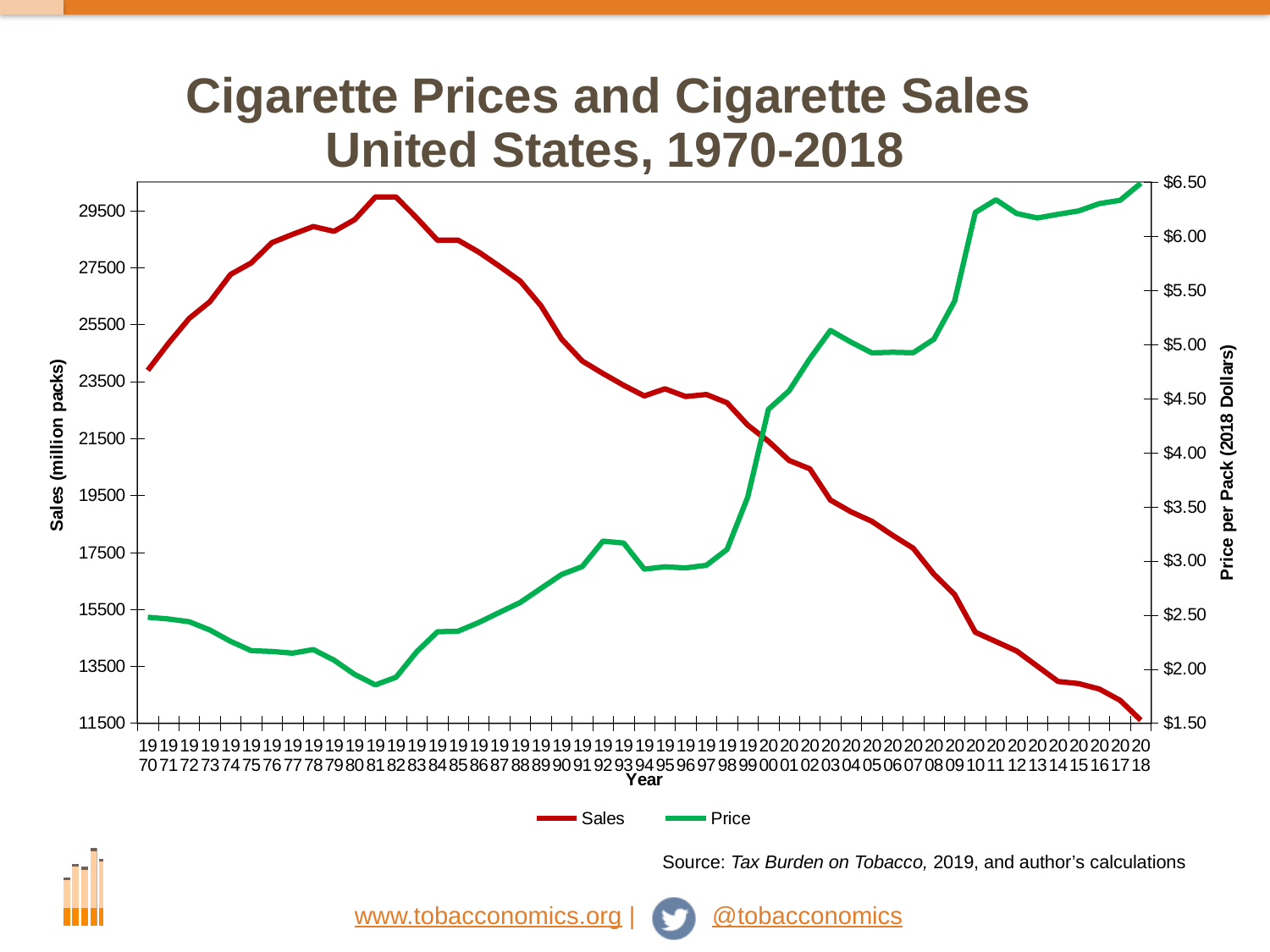
Is the Sales value for 2018 greater or less than 13500? less Which year has the larger Price value, 1970 or 2018? 2018 What is the label of the left vertical axis? Sales (million packs) In which year is the Price series at its highest? 2018 Is the Price value for 2018 greater or less than $6.00? greater What are the two series named in the legend? Sales and Price Is the Sales value for 1981 greater or less than 29500? greater How many series does the legend list? 2 What kind of chart is shown on the slide? line chart In which year is the Sales series at its lowest? 2018 Does the Sales series rise or fall from 1982 to 2018? fall